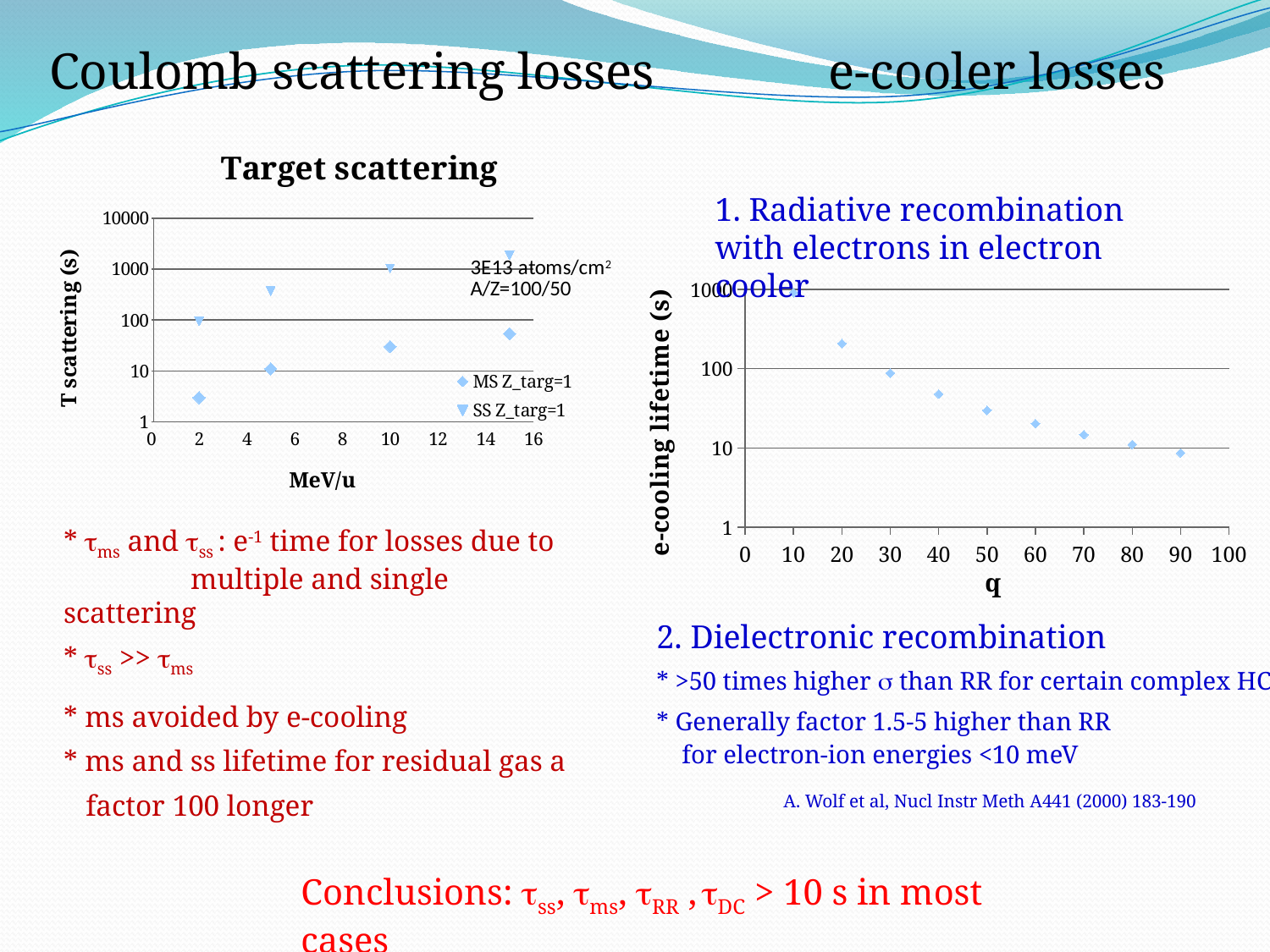
In the Target scattering chart, is the value of MS Z_targ=1 at 15 MeV/u greater or less than 100? less In the Target scattering chart, do the values of SS Z_targ=1 rise or fall as MeV/u increases? rise In the Target scattering chart, how many series does the legend list? 2 In the Target scattering chart, what kind of chart is used to show the data? Scatter chart In the e-cooling lifetime chart on the right, at which value of q is the e-cooling lifetime highest? 10 In the e-cooling lifetime chart on the right, does the e-cooling lifetime rise or fall as q increases? fall In the Target scattering chart, what is the label on the x axis? MeV/u In the Target scattering chart, is the value of MS Z_targ=1 at 2 MeV/u greater or less than 10? less In the Target scattering chart, which series has the larger value at 10 MeV/u, MS Z_targ=1 or SS Z_targ=1? SS Z_targ=1 In the Target scattering chart, is the value of SS Z_targ=1 at 5 MeV/u greater or less than 100? greater In the e-cooling lifetime chart on the right, how many data points are plotted? 9